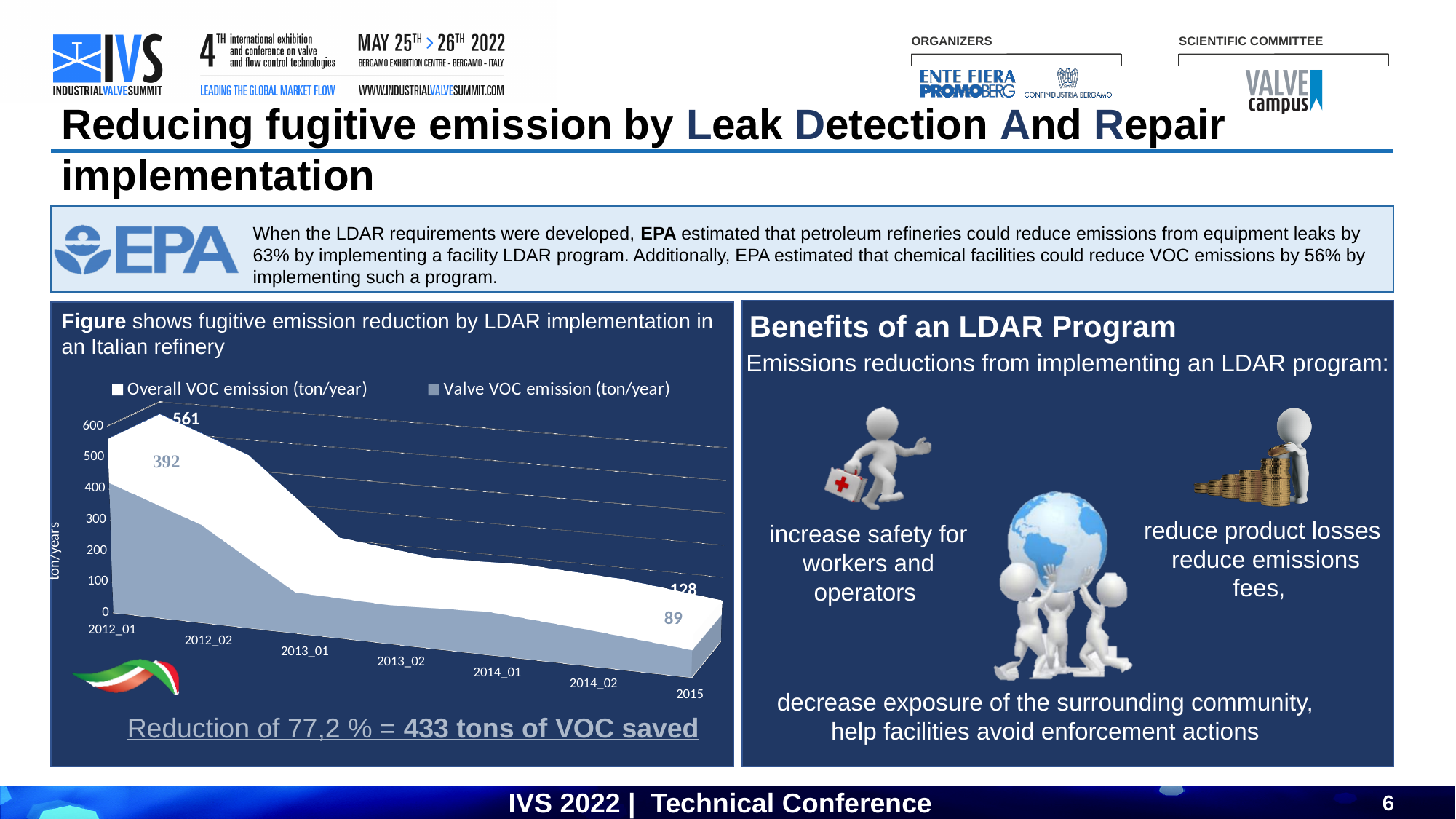
What is the Valve VOC emission (ton/year) value at 2012_01? 392 What is the difference between the Valve VOC emission values at 2012_01 and 2015? 303 Do the VOC emission values rise or fall from 2012_01 to 2015? fall Which is larger at 2015: Overall VOC emission or Valve VOC emission? Overall VOC emission By how much did the Overall VOC emission (ton/year) fall from 2012_01 to 2015? 433 What is the Overall VOC emission (ton/year) value at 2012_01? 561 How many series does the chart legend list? 2 How many time periods are shown on the x axis of the chart? 7 In which period is the Overall VOC emission highest? 2012_01 What is the Valve VOC emission (ton/year) value at 2015? 89 At 2012_01, what is the difference between Overall VOC emission and Valve VOC emission? 169 What is the Overall VOC emission (ton/year) value at 2015? 128